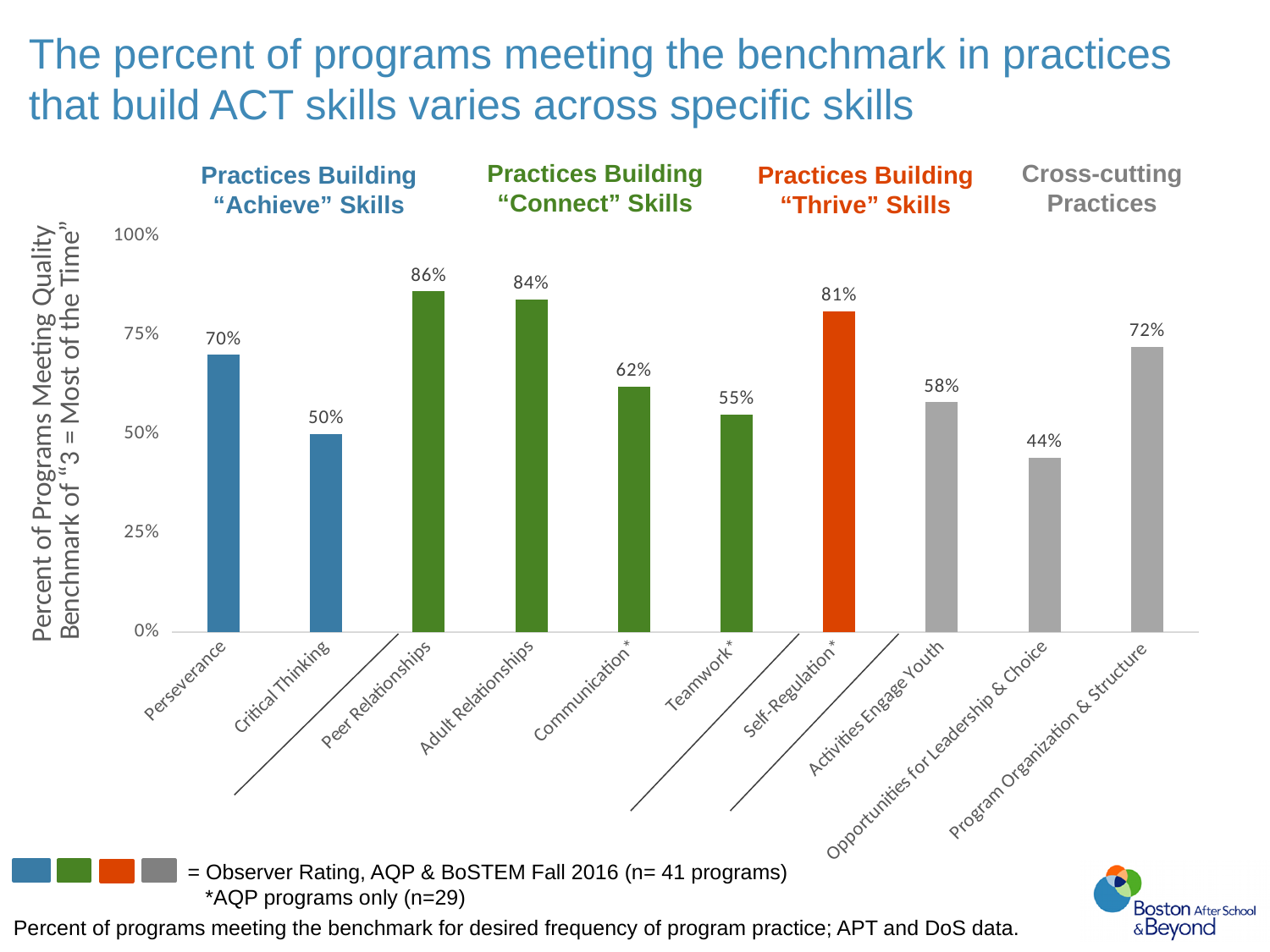
What is the value shown for Teamwork? 55% What is the difference between the values for Peer Relationships and Critical Thinking? 36% Which is larger, the value for Activities Engage Youth or the value for Perseverance? Perseverance What kind of chart is shown on the slide? Bar chart What colour are the bars for the Practices Building "Connect" Skills group? Green Which practice has the lowest percent of programs meeting the benchmark? Opportunities for Leadership & Choice How many practices (bars) are shown in the chart? 10 What percent of programs met the benchmark for Program Organization & Structure? 72% What is the difference between the values for Adult Relationships and Communication? 22% What percent of programs met the benchmark for Perseverance? 70% Which practice has the highest percent of programs meeting the benchmark? Peer Relationships What is the value shown for Self-Regulation? 81%